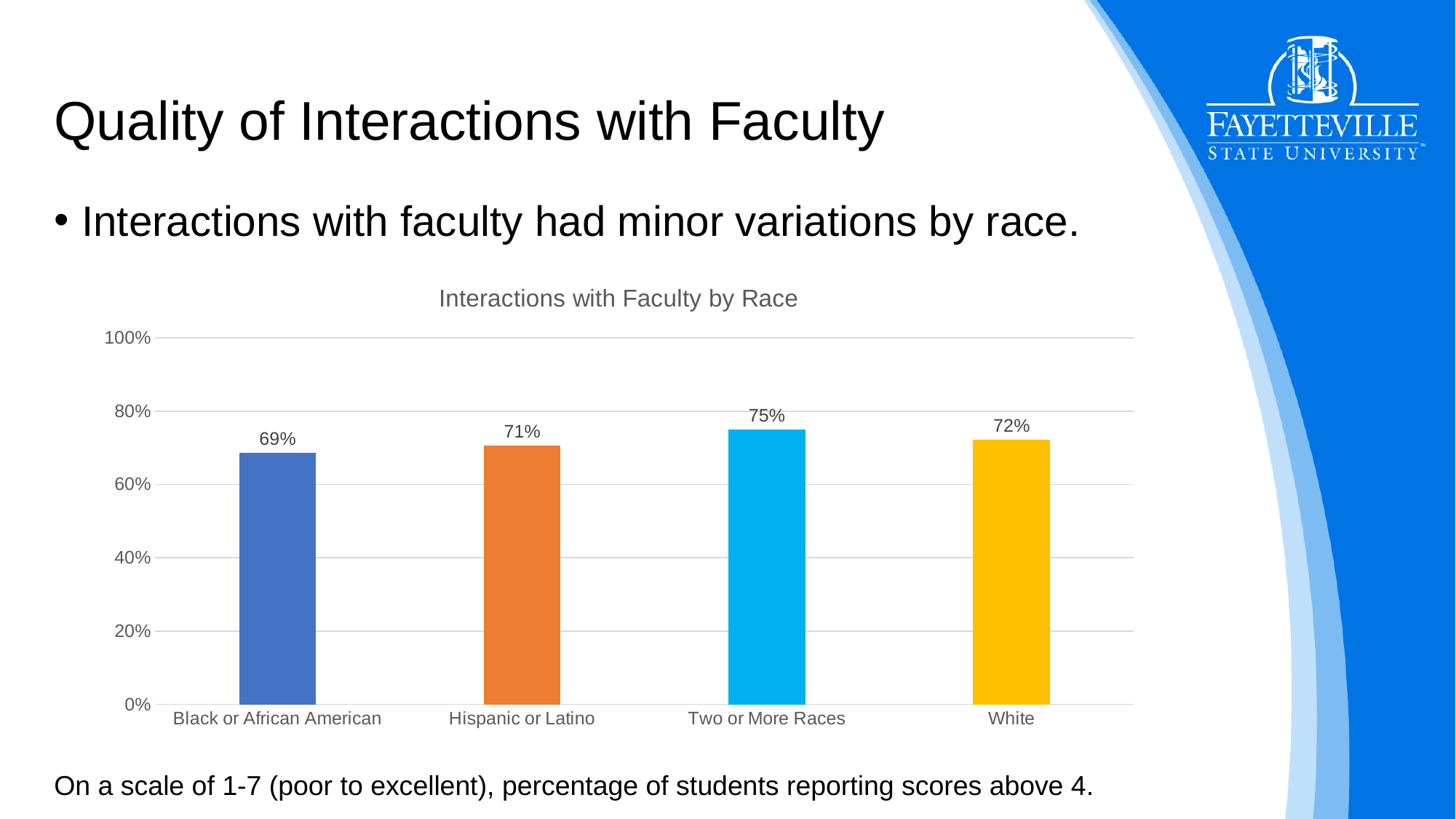
What kind of chart is shown on the slide? bar chart Which category has the highest value? Two or More Races How many categories are shown in the chart? 4 What is the value for White? 72% What is the value for Hispanic or Latino? 71% What is the value for Black or African American? 69% Is the value for Two or More Races greater or less than 80%? less What is the value for Two or More Races? 75% What is the difference between the values for Two or More Races and Black or African American? 6% Which category has the lowest value? Black or African American What is the title of the chart? Interactions with Faculty by Race Which is larger, the value for White or the value for Hispanic or Latino? White